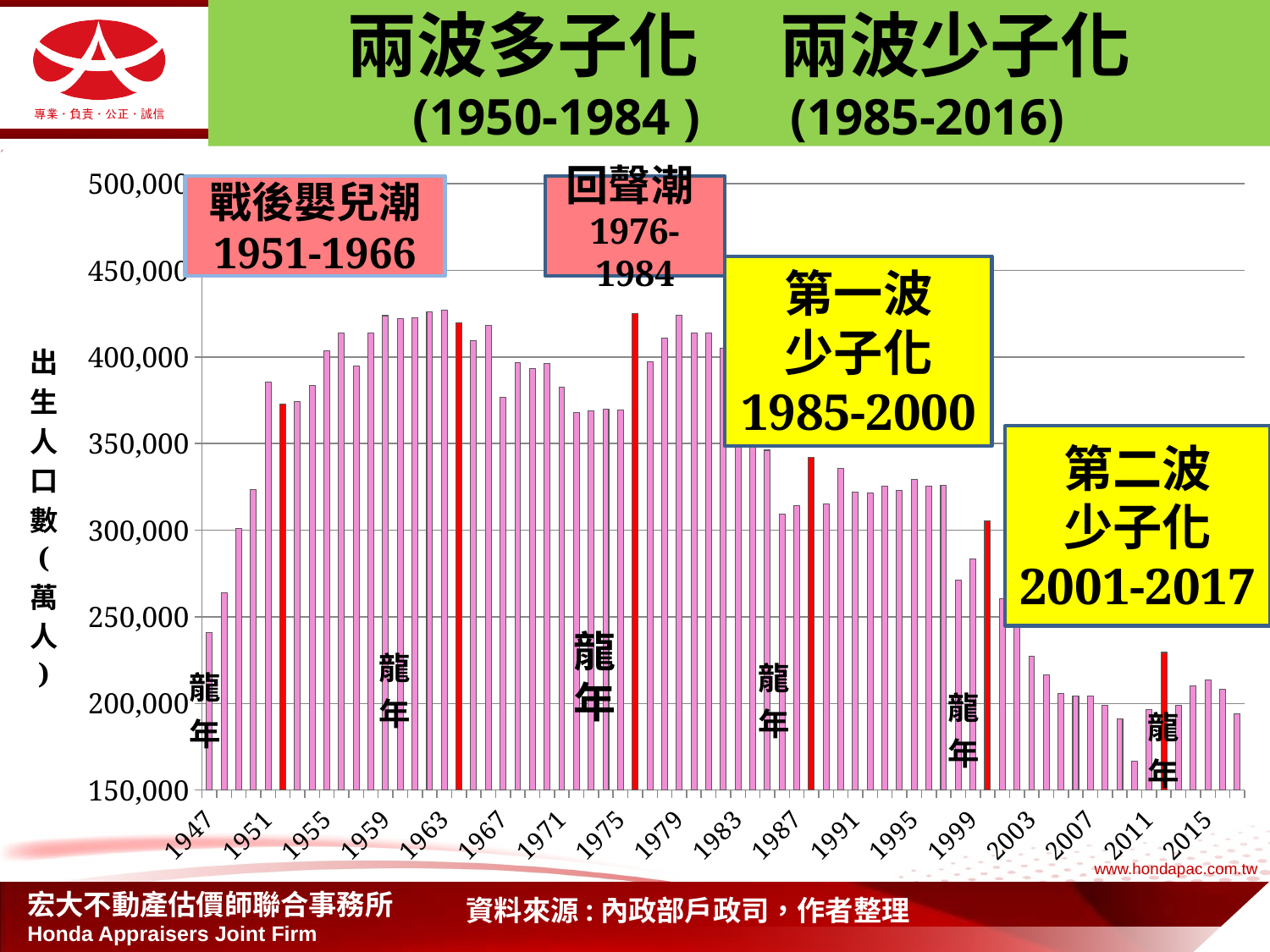
Which year has the larger value, 1963 or 2011? 1963 Do the values generally rise or fall from 1985 to 2011? fall Is the value for 1951 greater or less than 300,000? greater What period does the annotation 戰後嬰兒潮 (post-war baby boom) cover? 1951-1966 Is the value for 1947 greater or less than 250,000? less Which year has the larger value, 1947 or 1951? 1951 Is the value for 1999 greater or less than 300,000? less What is the lowest value shown on the y axis? 150,000 What kind of chart is shown on the slide? bar chart